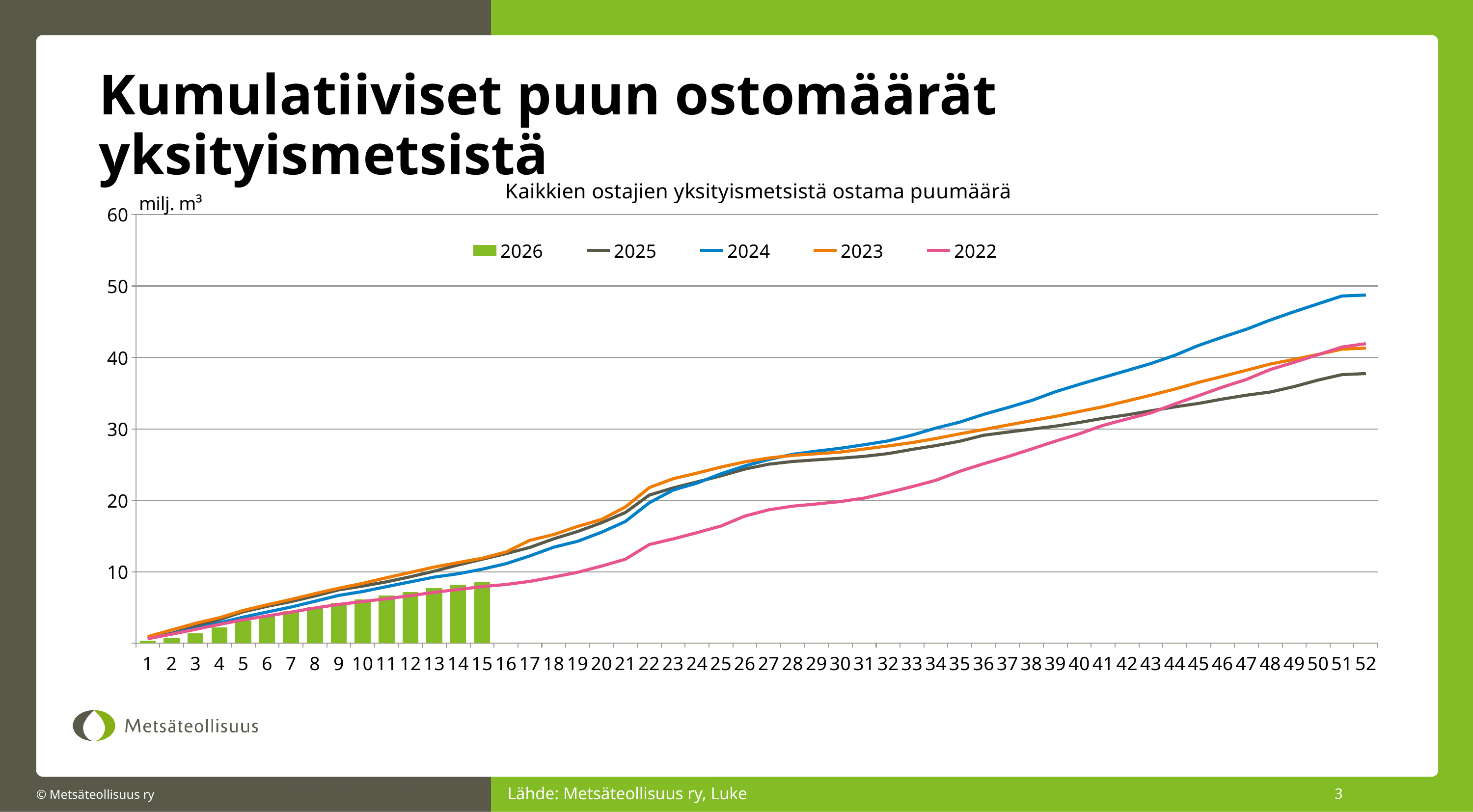
Which series has the highest value at week 52? 2024 Which line series has the lowest value at week 52? 2025 What kind of chart is shown on the slide? A combined bar and line chart What is the title of the chart? Kaikkien ostajien yksityismetsistä ostama puumäärä Is the value for 2024 at week 52 greater or less than 50? less How many weeks are shown on the x axis? 52 How many series does the legend list? 5 Is the value for 2026 at week 15 greater or less than 10? less At week 30, which is larger: the value for 2024 or the value for 2022? 2024 Is the value for 2025 at week 52 greater or less than 40? less Which series is shown as bars rather than a line? 2026 How many bars are plotted for the 2026 series? 15